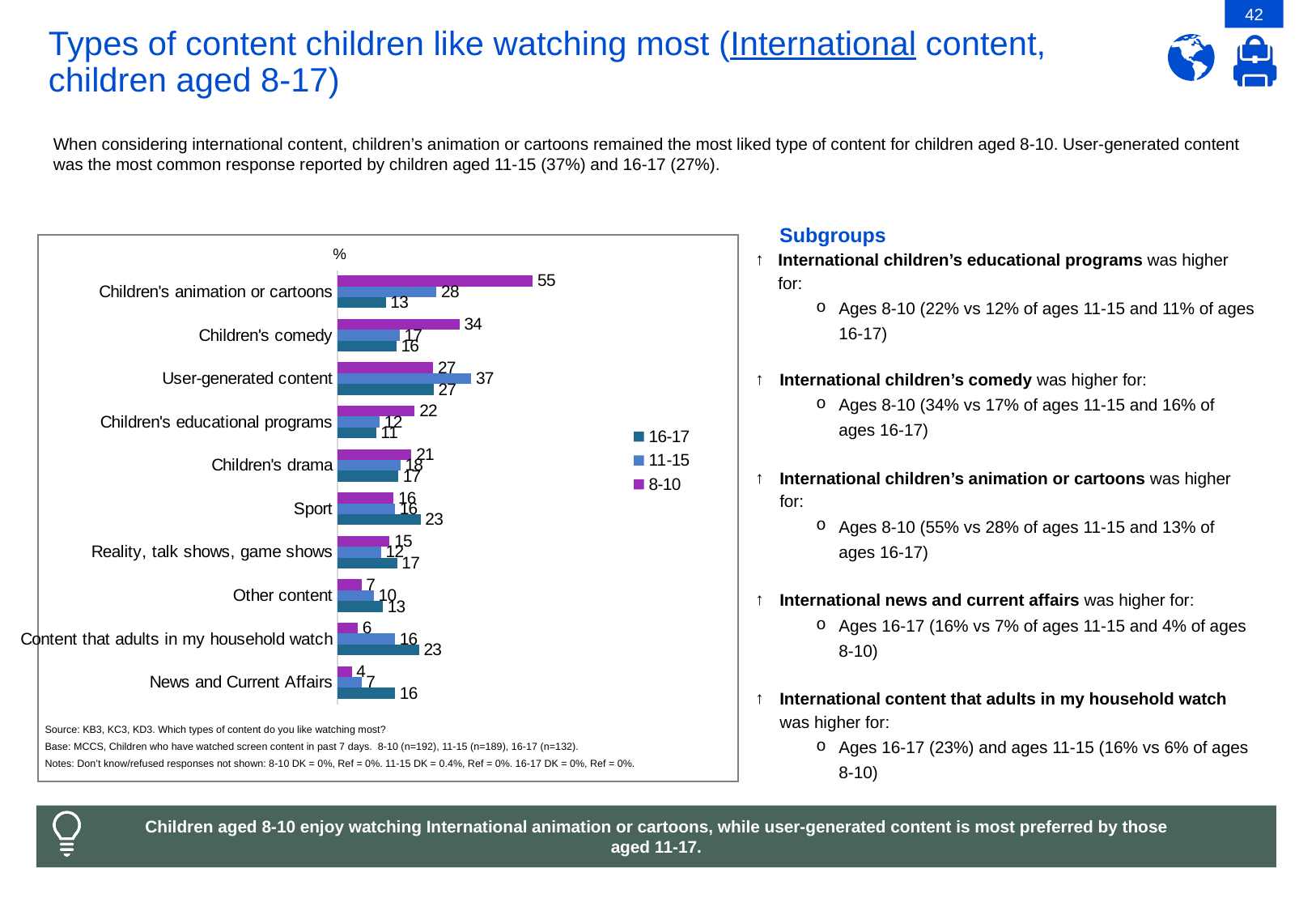
For content that adults in my household watch, which age group has the larger value: 16-17 or 8-10? 16-17 What is the value for the 11-15 age group for user-generated content? 37 How many types of content are shown in the chart? 10 How many age groups does the legend list? 3 Which colour represents the 8-10 age group in the chart? Purple What is the difference between the 8-10 and 16-17 values for children's animation or cartoons? 42 What is the value for the 16-17 age group for sport? 23 What percentage of children aged 8-10 like watching children's animation or cartoons most? 55 Which type of content has the lowest value for the 8-10 age group? News and Current Affairs What is the value for the 16-17 age group for news and current affairs? 16 Which type of content has the highest value for the 8-10 age group? Children's animation or cartoons What kind of chart is shown on the slide? Bar chart